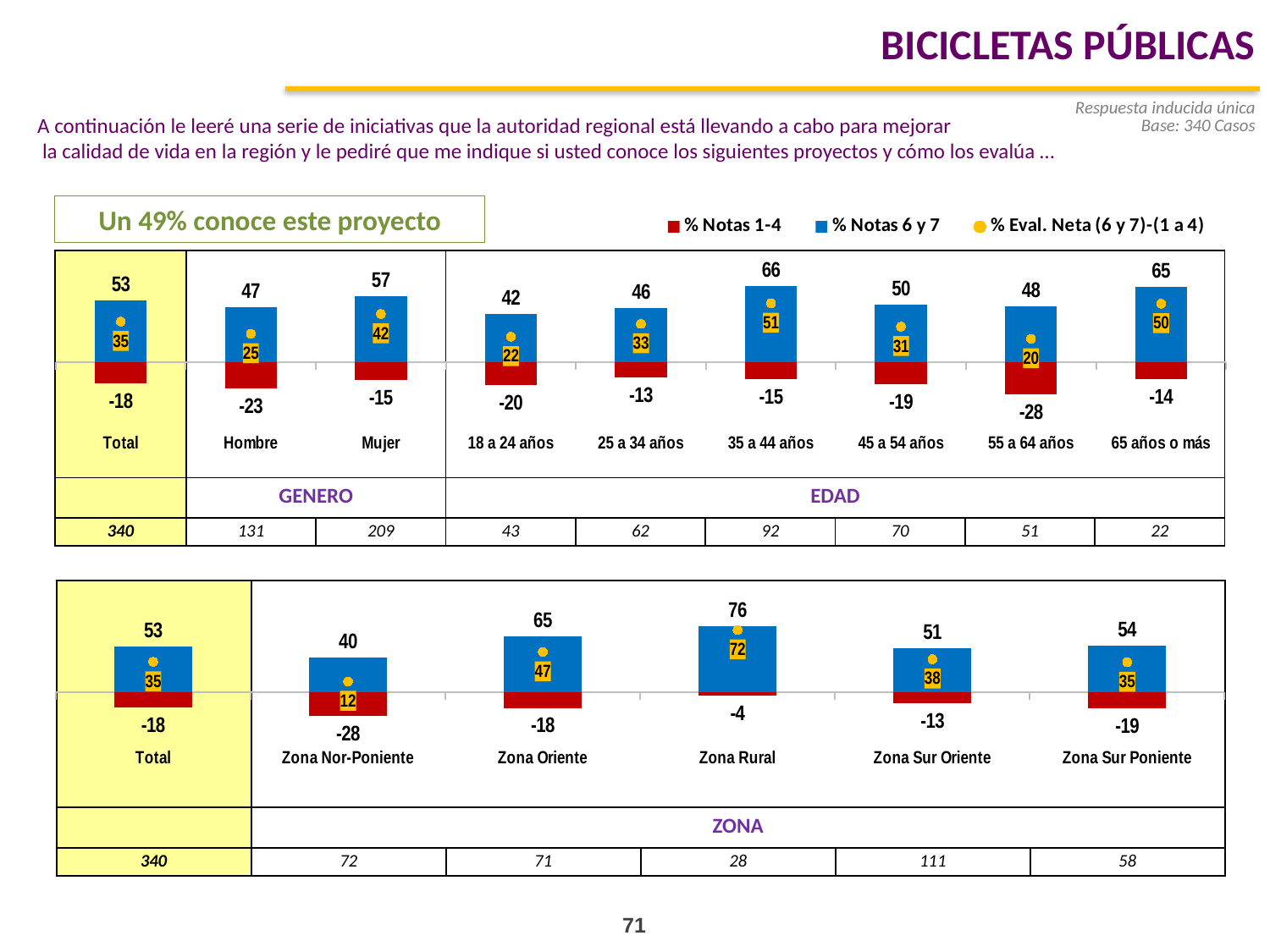
In the top chart (Género/Edad), which age group has the highest % Notas 6 y 7 value? 35 a 44 años In the bottom chart (Zona), which is larger, the % Notas 6 y 7 value for Zona Oriente or for Zona Sur Poniente? Zona Oriente In the bottom chart (Zona), which zone has the lowest % Eval. Neta value? Zona Nor-Poniente In the bottom chart (Zona), how many zone categories are plotted, excluding Total? 5 In the top chart (Género/Edad), what is the % Notas 1-4 value for 55 a 64 años? -28 In the top chart (Género/Edad), what is the % Notas 6 y 7 value for Mujer? 57 In the top chart (Género/Edad), what is the difference between the % Notas 6 y 7 values for Mujer and Hombre? 10 In the bottom chart (Zona), which zone has the highest % Notas 6 y 7 value? Zona Rural In the top chart (Género/Edad), what is the % Eval. Neta value for 65 años o más? 50 How many series does the legend list for the charts? 3 What kind of chart is used in the top chart (Género/Edad)? Combination bar and line chart (stacked bars with dot markers for the net evaluation series) In the bottom chart (Zona), what is the % Notas 1-4 value for Zona Rural? -4